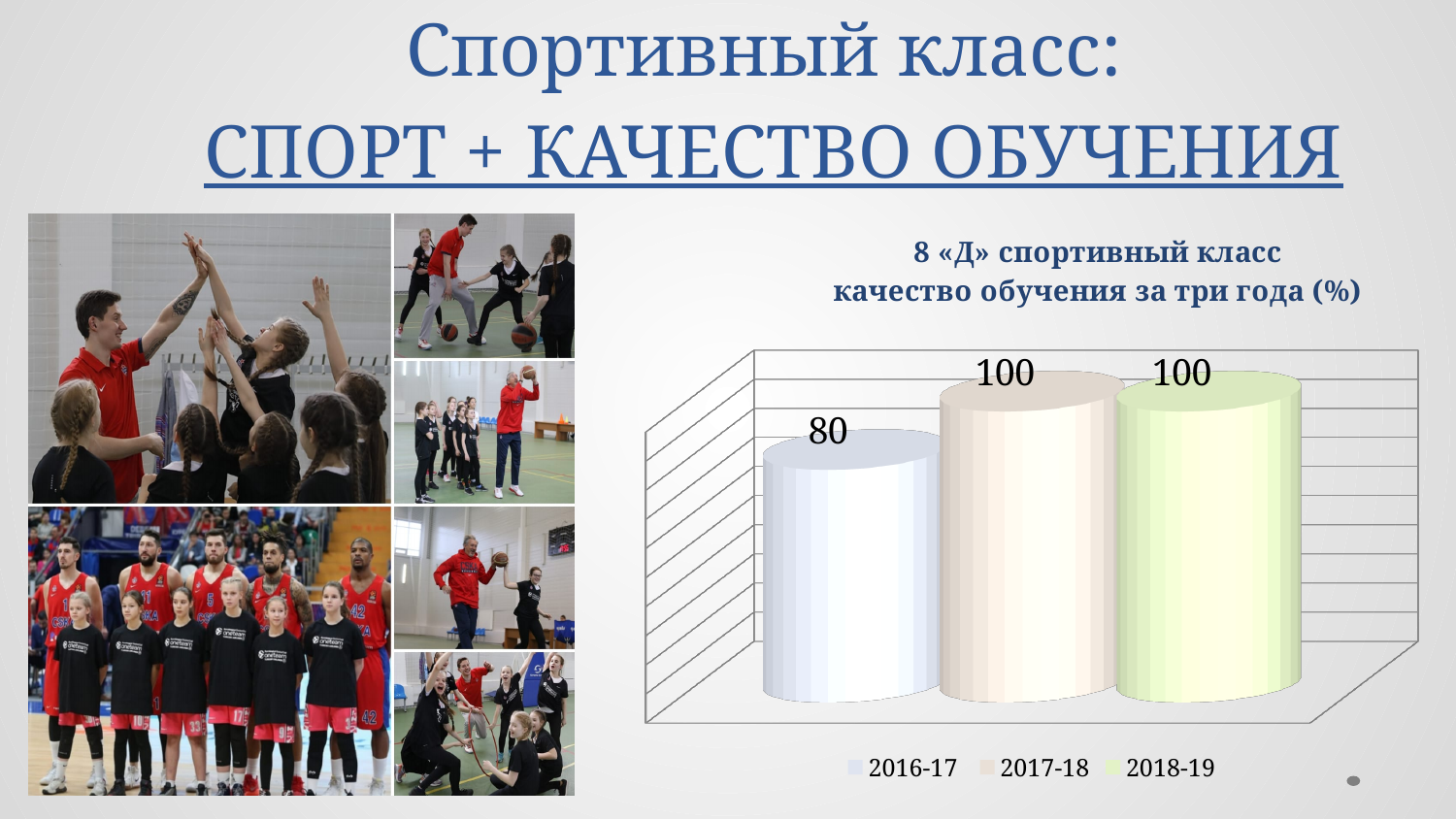
Which is larger, the value for 2016-17 or the value for 2018-19? 2018-19 What kind of chart is shown on the slide? Bar chart Do the values rise or fall from 2016-17 to 2018-19? Rise What is the value for 2018-19? 100 Which year has the lowest value? 2016-17 What is the difference between the values for 2017-18 and 2016-17? 20 What is the title of the chart? 8 «Д» спортивный класс качество обучения за три года (%) How many bars are plotted on the chart? 3 How many entries does the legend list? 3 What is the value for 2016-17? 80 Which legend entry is listed first? 2016-17 What is the value for 2017-18? 100